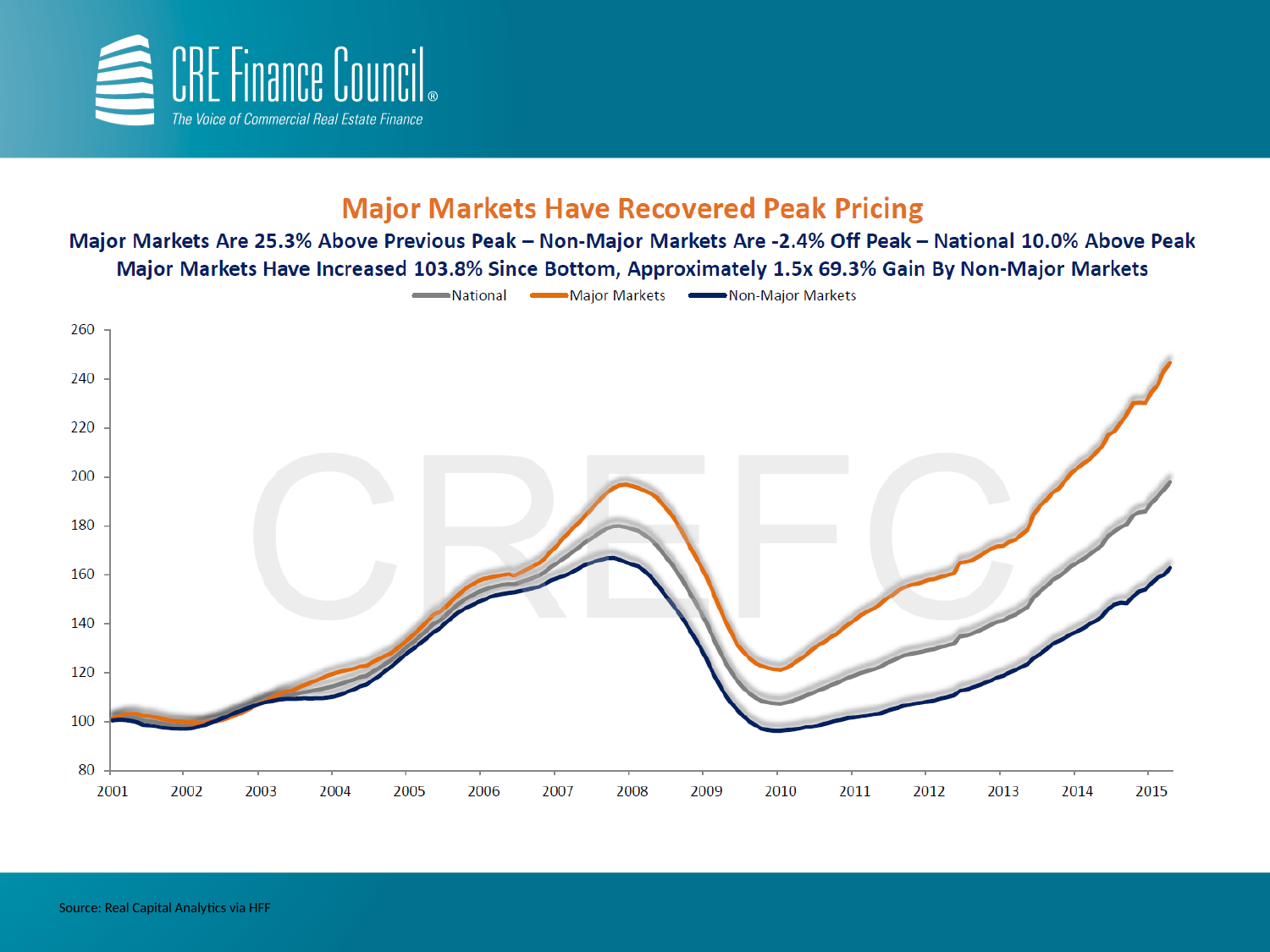
How many series does the legend list? 3 What kind of chart is shown on the slide? line chart Is the value for Major Markets at the end of 2015 greater or less than 220? greater What colour is the Major Markets line? orange Is the value for National at the end of 2015 greater or less than 180? greater How many year labels are shown on the x axis? 15 Which series has the highest value at the end of 2015? Major Markets Do the Major Markets values rise or fall from 2010 to 2015? rise Is the value for Non-Major Markets at the start of 2010 greater or less than 100? less Which series has the lowest value at the end of 2015? Non-Major Markets What is the title of the chart? Major Markets Have Recovered Peak Pricing